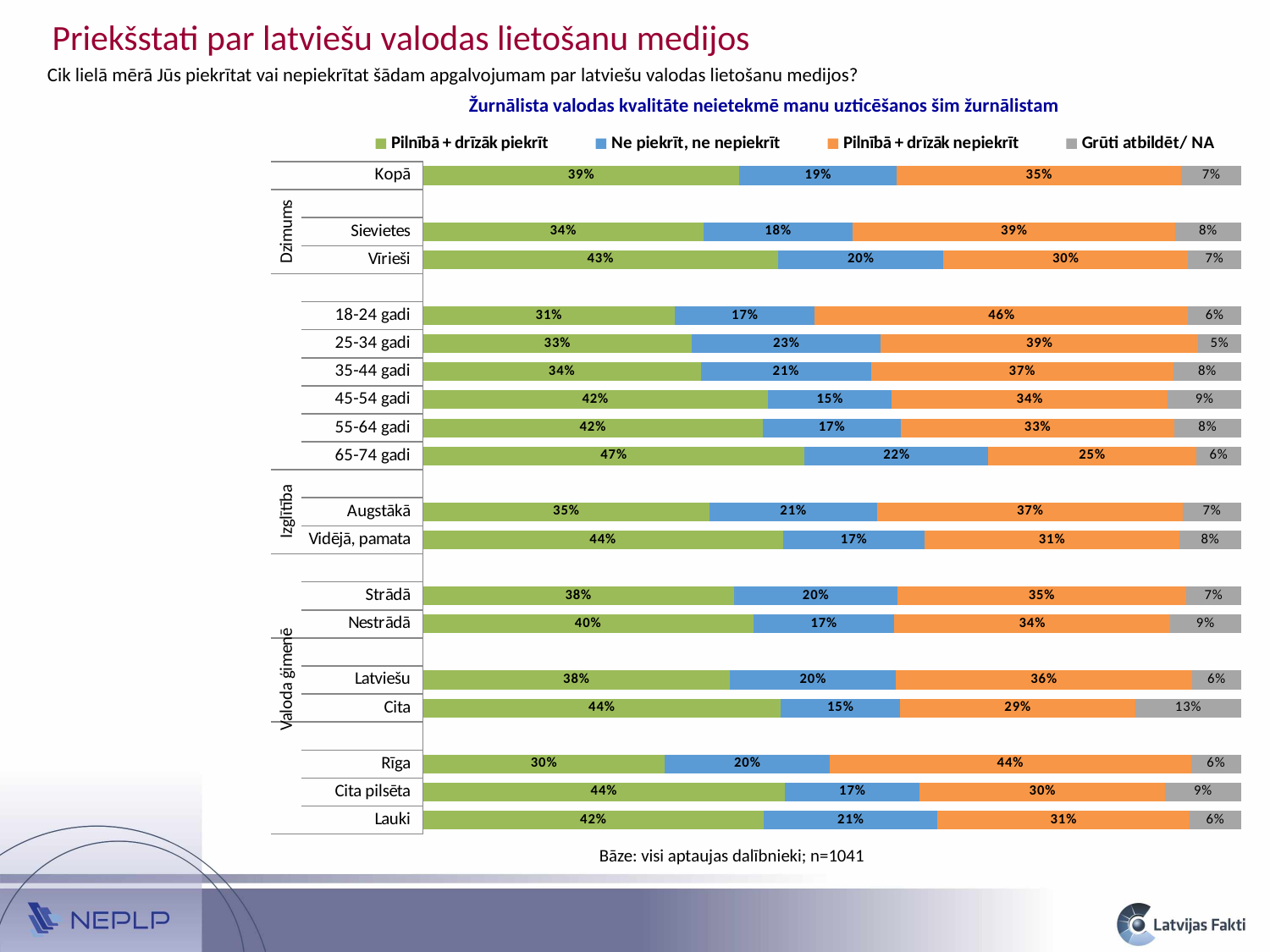
Which is larger: the "Pilnībā + drīzāk nepiekrīt" value for Rīga or for Lauki? Rīga Which category has the lowest value for "Pilnībā + drīzāk piekrīt"? Rīga What kind of chart is shown on the slide? Stacked bar chart What is the value of "Grūti atbildēt/ NA" for Cita? 13% How many series does the legend list? 4 What is the sample size stated below the chart? n=1041 What is the value of "Ne piekrīt, ne nepiekrīt" for 25-34 gadi? 23% Which age group has the highest value for "Pilnībā + drīzāk piekrīt"? 65-74 gadi What is the value of "Pilnībā + drīzāk nepiekrīt" for 18-24 gadi? 46% How many categories (rows) are plotted in the chart? 18 What is the value of "Pilnībā + drīzāk piekrīt" for Kopā? 39% What is the difference between the "Pilnībā + drīzāk piekrīt" values for Vīrieši and Sievietes? 9 percentage points